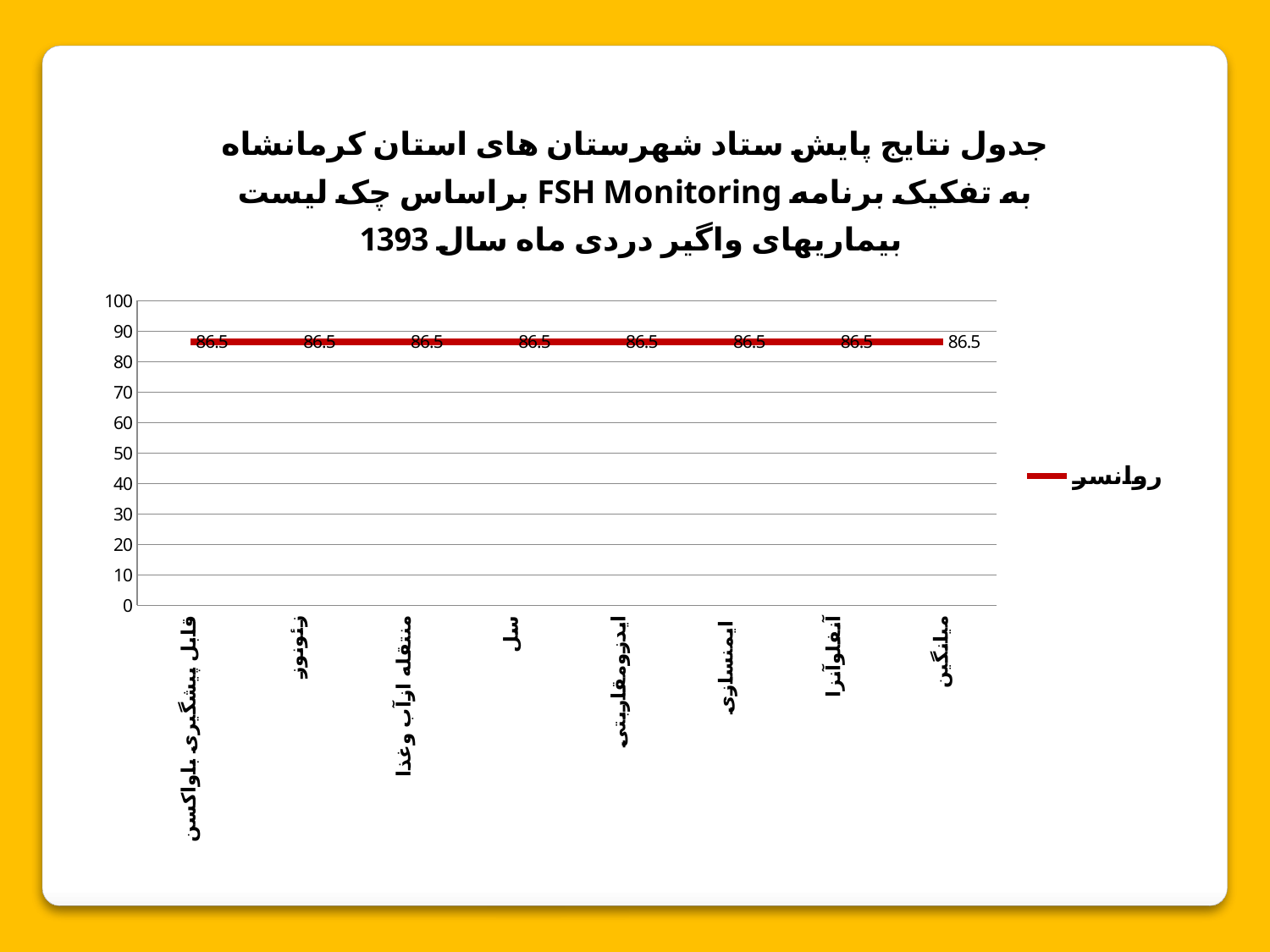
What is the value for زئونوز? 86.5 What is the value for آنفلوآنزا? 86.5 What is the value for میانگین? 86.5 What kind of chart is this? line chart Is the value for ایدز و مقاربتی greater or less than 80? greater Do the values rise, fall, or stay flat across the categories? stay flat How many categories are shown on the x axis? 8 What is the name of the series shown in the legend? روانسر What is the value for سل? 86.5 How many series does the legend list? 1 Is the value for منتقله از آب و غذا greater or less than 90? less What is the difference between the values for ایمنسازی and سل? 0